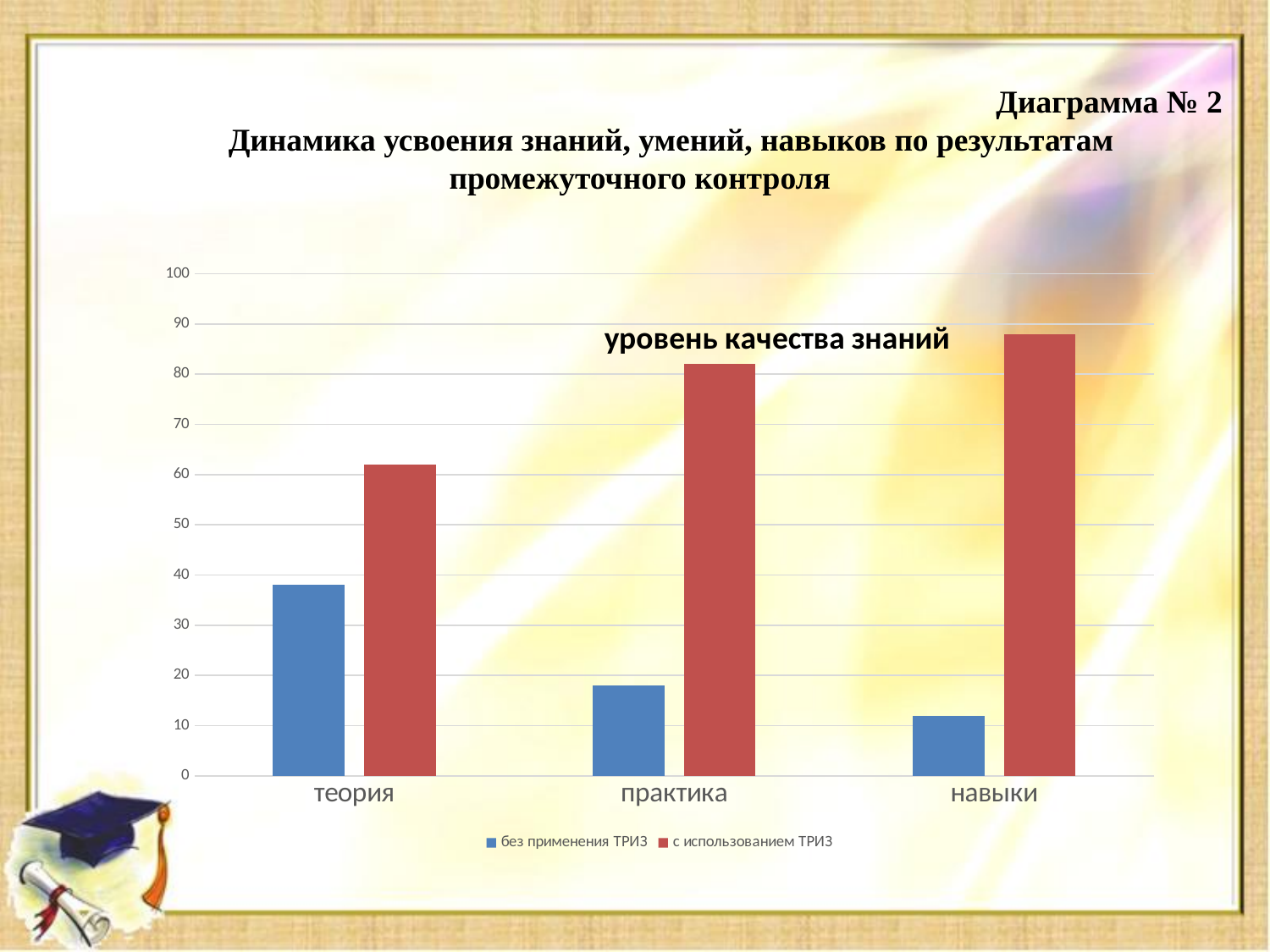
How many series does the chart legend list? 2 Which category has the highest value for the series 'с использованием ТРИЗ'? навыки What kind of chart is shown on the slide? bar chart Do the values for the series 'без применения ТРИЗ' rise or fall from 'теория' to 'навыки'? fall For 'навыки', which series has the larger value: 'без применения ТРИЗ' or 'с использованием ТРИЗ'? с использованием ТРИЗ Which category has the highest value for the series 'без применения ТРИЗ'? теория How many categories are shown on the x axis of the chart? 3 Which category has the lowest value for the series 'без применения ТРИЗ'? навыки Which series is shown in red in the chart? с использованием ТРИЗ Is the value for 'практика' in the series 'с использованием ТРИЗ' greater or less than 80? greater What is the title printed inside the chart area? уровень качества знаний Is the value for 'теория' in the series 'без применения ТРИЗ' greater or less than 40? less